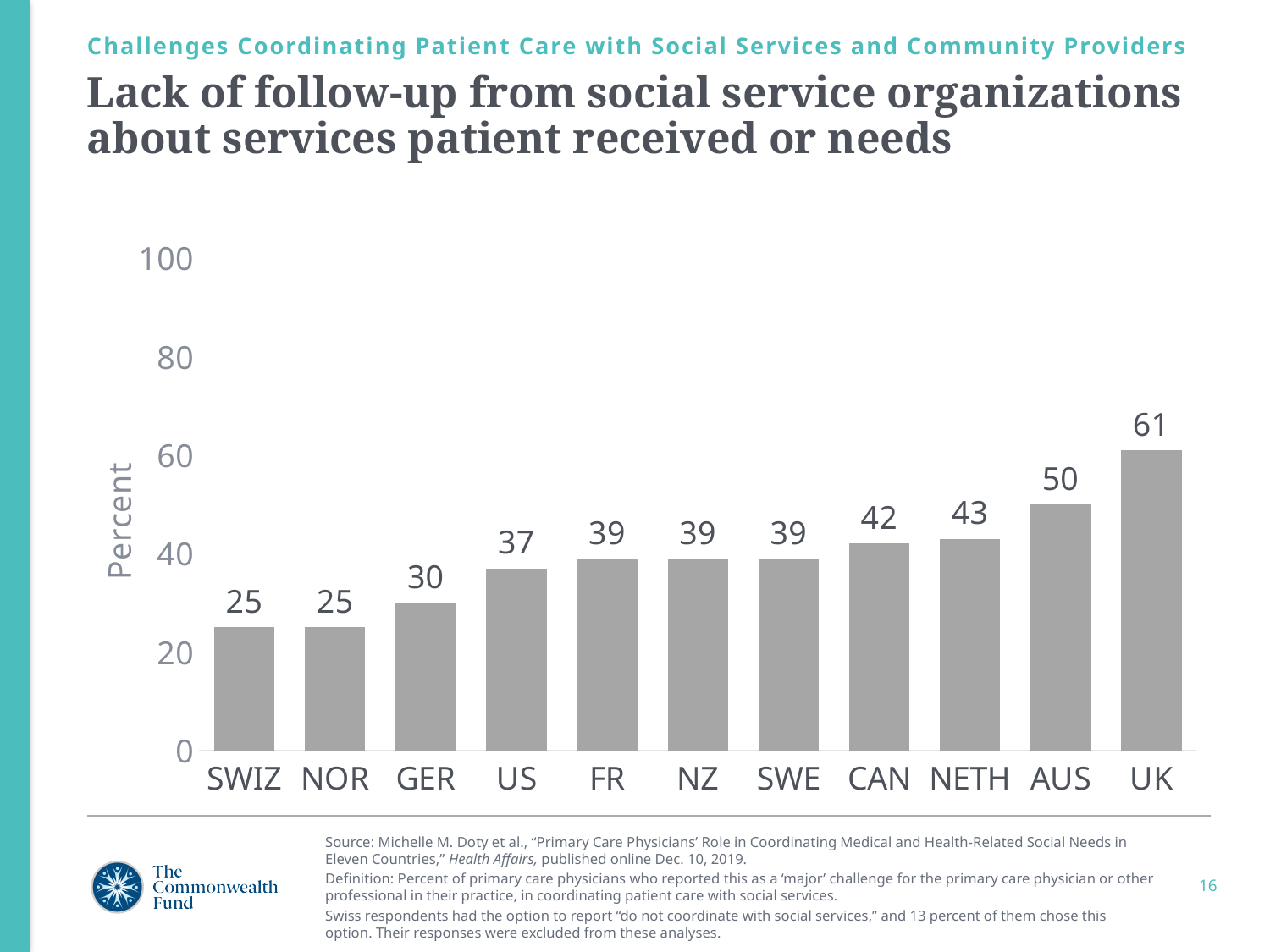
What kind of chart is shown on the slide? bar chart What is the value for GER? 30 What is the difference between the values for the UK and SWIZ? 36 What is the label on the vertical axis? Percent How many countries are shown on the chart? 11 What is the value for CAN? 42 What is the value for the UK? 61 Is the value for the UK greater or less than 60? greater Which is larger, the value for US or the value for AUS? AUS Do the values generally rise or fall from left to right along the x axis? rise Which country has the highest value? UK What is the difference between the values for AUS and NETH? 7